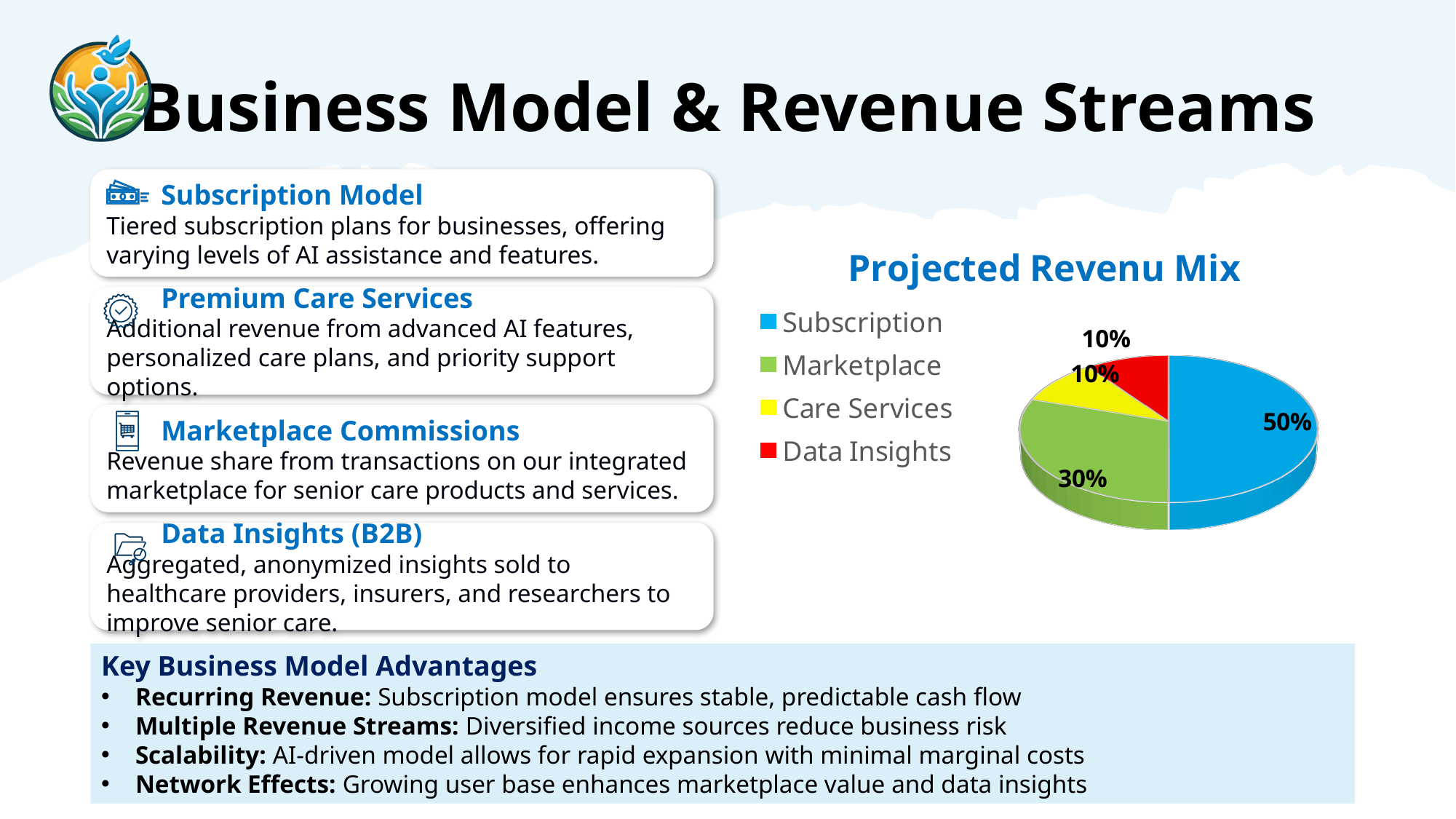
What share of the projected revenue mix comes from Data Insights? 10% What kind of chart is shown on the slide? pie chart How many slices does the pie chart have? 4 What share of the projected revenue mix comes from Subscription? 50% What share of the projected revenue mix comes from Marketplace? 30% How many entries does the legend list? 4 What share of the projected revenue mix comes from Care Services? 10% What colour is the Care Services slice in the pie chart? yellow Which is larger, the Marketplace slice or the Data Insights slice? Marketplace Which revenue stream has the largest slice of the pie? Subscription What is the chart's title? Projected Revenu Mix What is the difference in percentage points between the Subscription and Marketplace slices? 20%